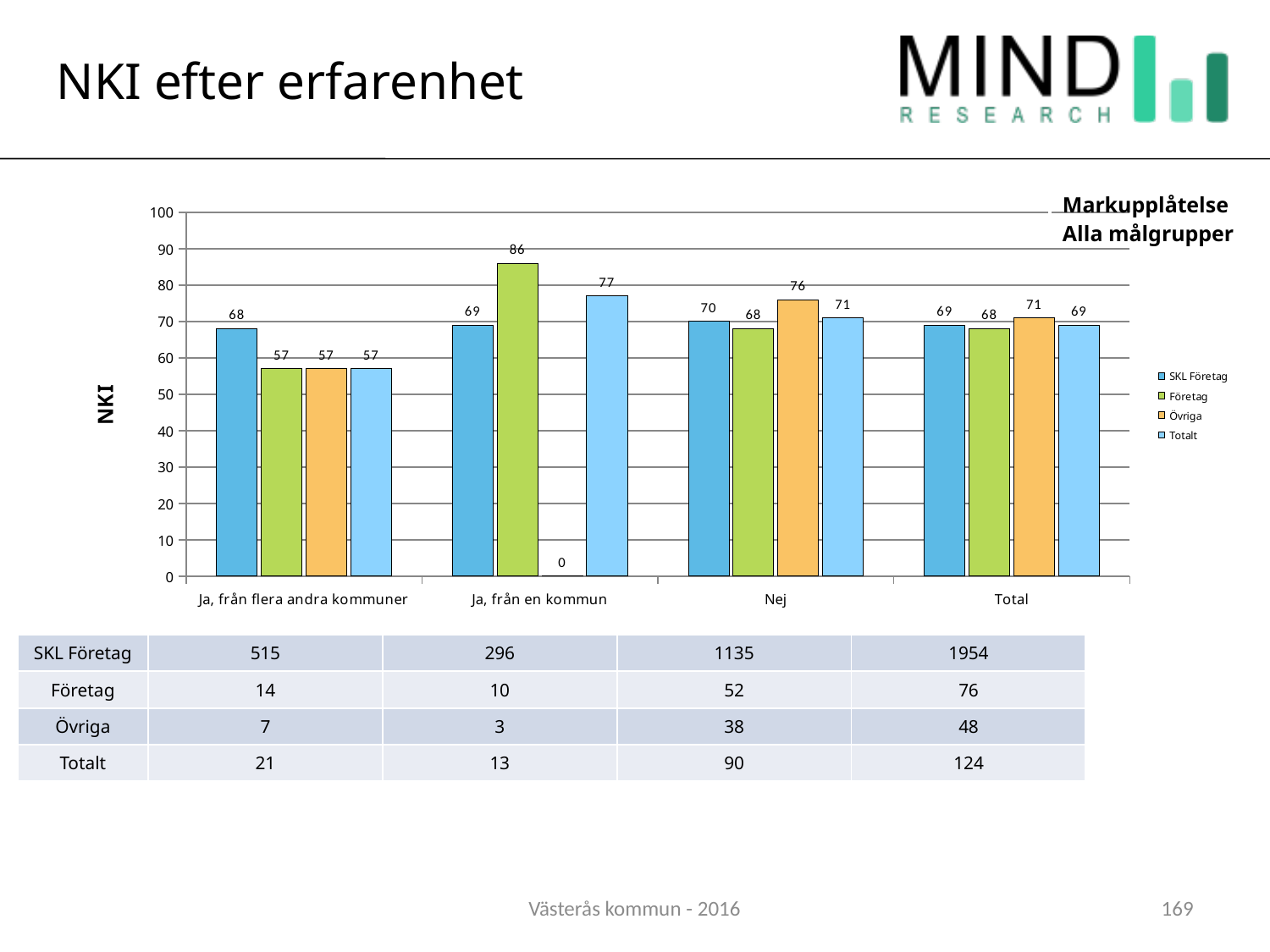
What is the Totalt value for the category "Ja, från en kommun"? 77 What is the difference between the Företag value and the SKL Företag value in the category "Ja, från en kommun"? 17 Which series has the highest NKI value in the category "Ja, från flera andra kommuner"? SKL Företag What is the NKI value for Företag in the category "Ja, från en kommun"? 86 What is the label of the y axis of the chart? NKI How many series does the chart legend list? 4 What is the NKI value for SKL Företag in the category "Nej"? 70 How many categories are shown on the x axis of the chart? 4 What kind of chart is shown on the slide? Bar chart Which is larger: the Övriga value for "Nej" or the Övriga value for "Total"? Nej What is the NKI value for Övriga in the category "Ja, från en kommun"? 0 Which series has the lowest NKI value in the category "Ja, från en kommun"? Övriga